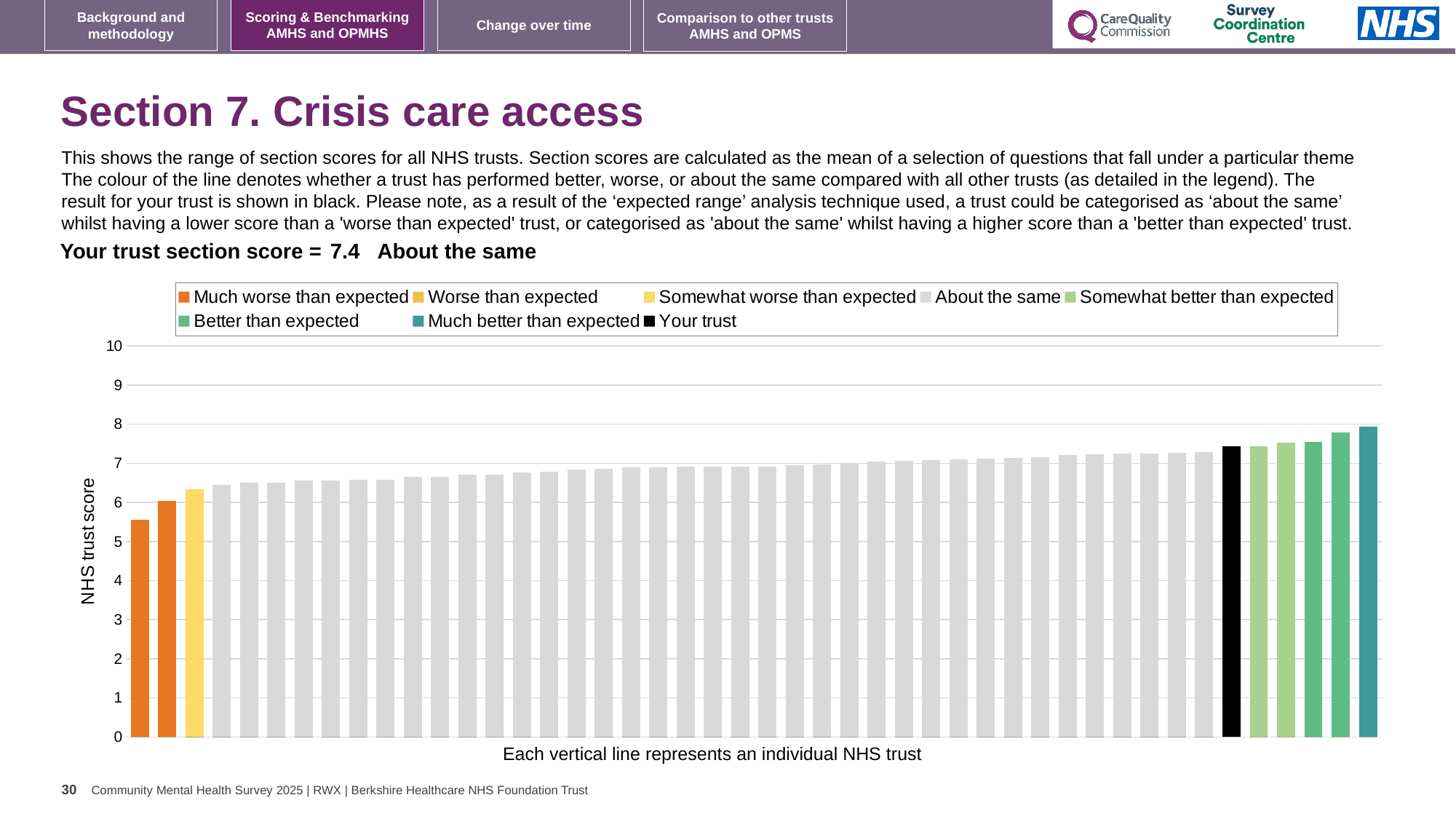
Is the value of the black 'Your trust' bar greater or less than 7? greater Is the value of the lowest bar in the chart greater or less than 6? less What kind of chart is shown on the slide? Bar chart What is the section score for your trust shown on the slide? 7.4 Which legend category does the tallest bar belong to? Much better than expected Which category is your trust placed in according to the slide? About the same What is the label on the vertical axis of the chart? NHS trust score How many bars are coloured as 'Much worse than expected'? 2 How many bars are coloured as 'Much better than expected'? 1 Do the bar values rise or fall from left to right along the x axis? rise How many entries does the chart legend list? 8